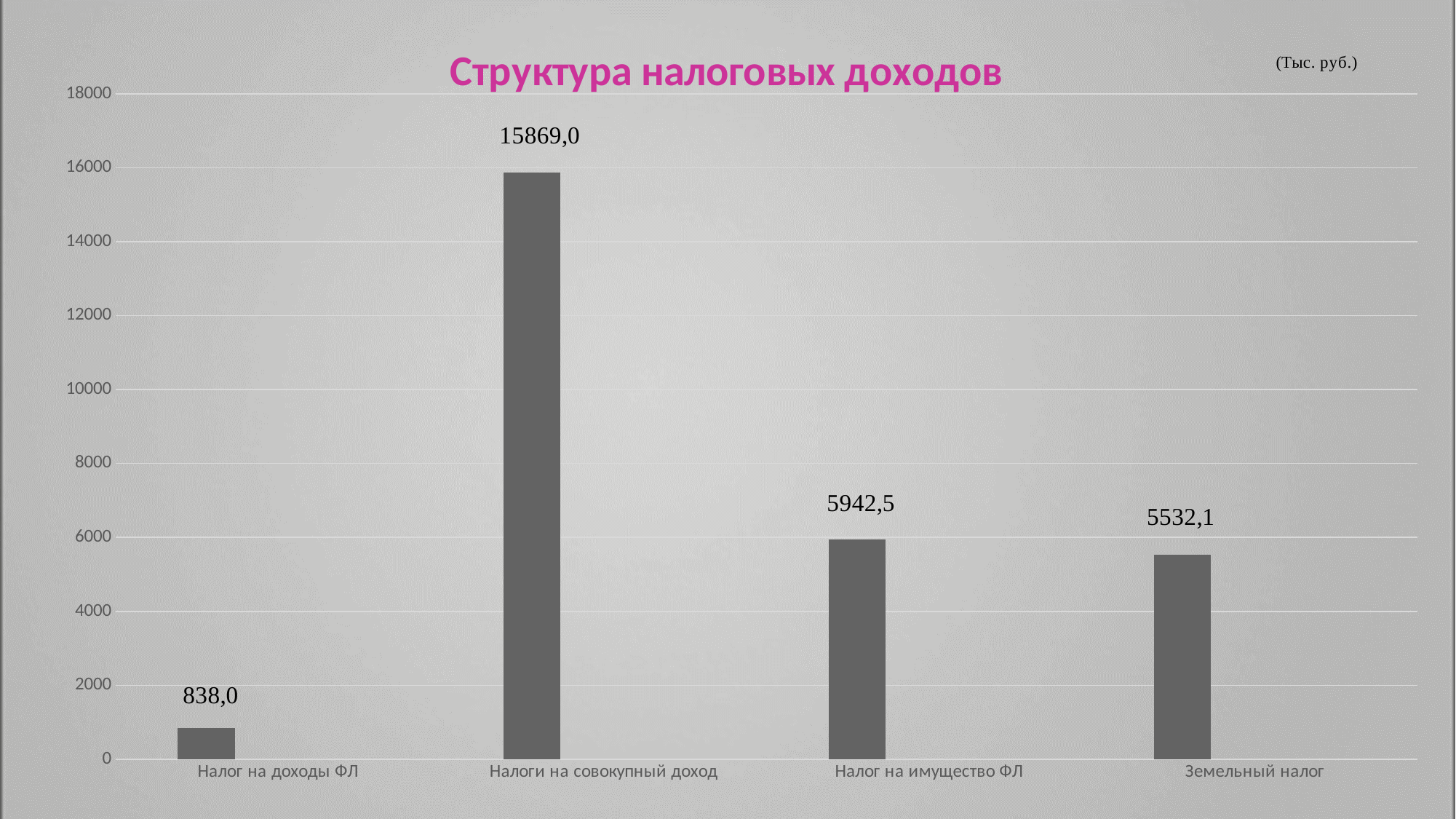
What is the value for Земельный налог? 5532,1 What is the value for Налог на имущество ФЛ? 5942,5 What is the value for Налог на доходы ФЛ? 838,0 Which is larger, Налог на имущество ФЛ or Земельный налог? Налог на имущество ФЛ What is the difference between Налог на имущество ФЛ and Земельный налог? 410,4 Which category has the highest value? Налоги на совокупный доход What is the value for Налоги на совокупный доход? 15869,0 Which category has the lowest value? Налог на доходы ФЛ Is the value for Налоги на совокупный доход greater or less than 14000? greater What kind of chart is shown on the slide? bar chart What is the title of the chart? Структура налоговых доходов How many categories are shown in the chart? 4